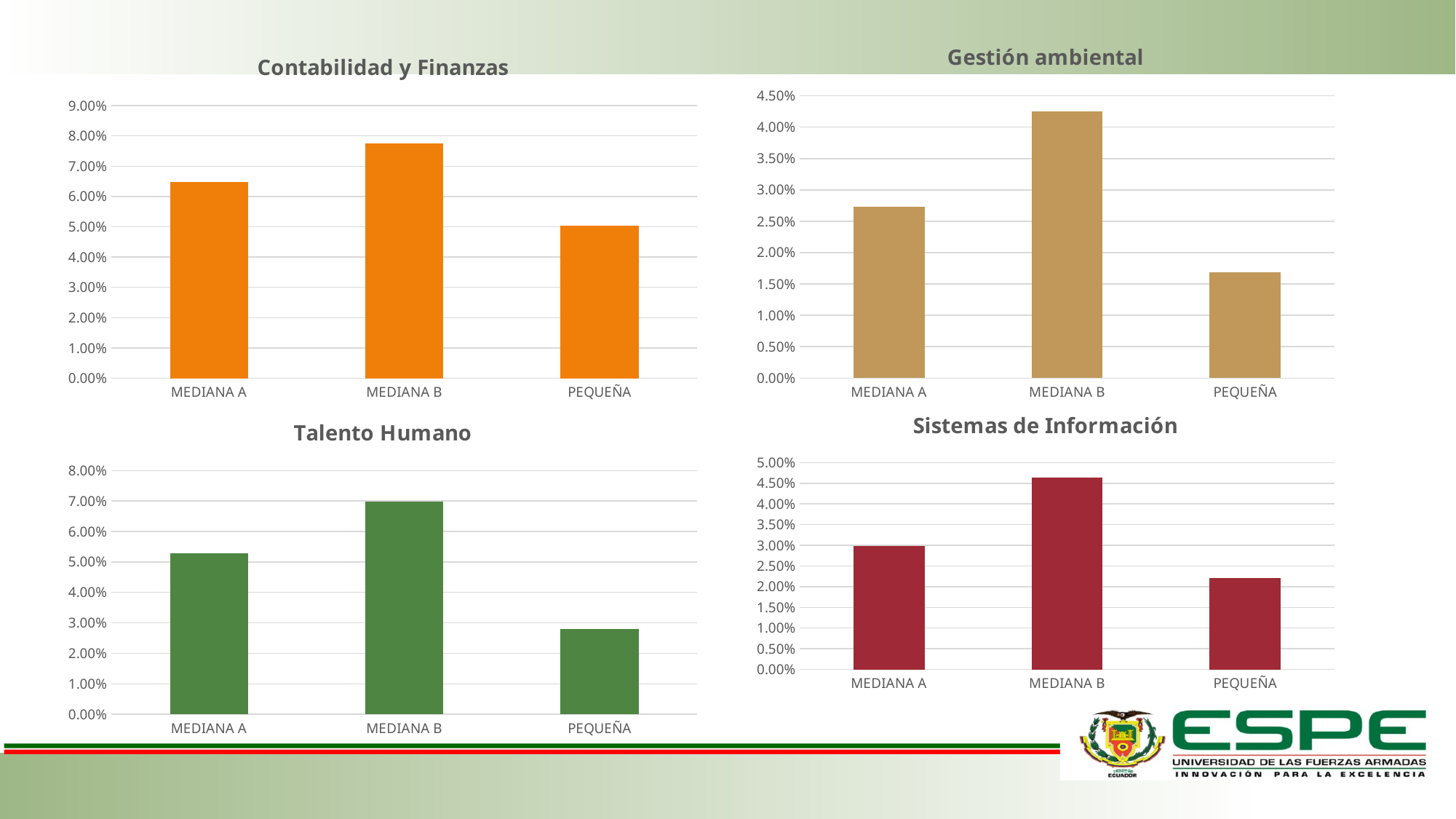
In the Talento Humano chart, which is larger, the value for MEDIANA A or the value for PEQUEÑA? MEDIANA A In the Sistemas de Información chart, which category has the highest value? MEDIANA B What type of chart is the Gestión ambiental chart? Bar chart In the Gestión ambiental chart, is the value for MEDIANA B greater or less than 4.00%? greater In the Gestión ambiental chart, which category has the lowest value? PEQUEÑA In the Talento Humano chart, is the value for PEQUEÑA greater or less than 3.00%? less In the Sistemas de Información chart, is the value for PEQUEÑA greater or less than 2.00%? greater How many charts are shown on the slide? 4 In the Contabilidad y Finanzas chart, which category has the highest value? MEDIANA B How many categories are shown in the Talento Humano chart? 3